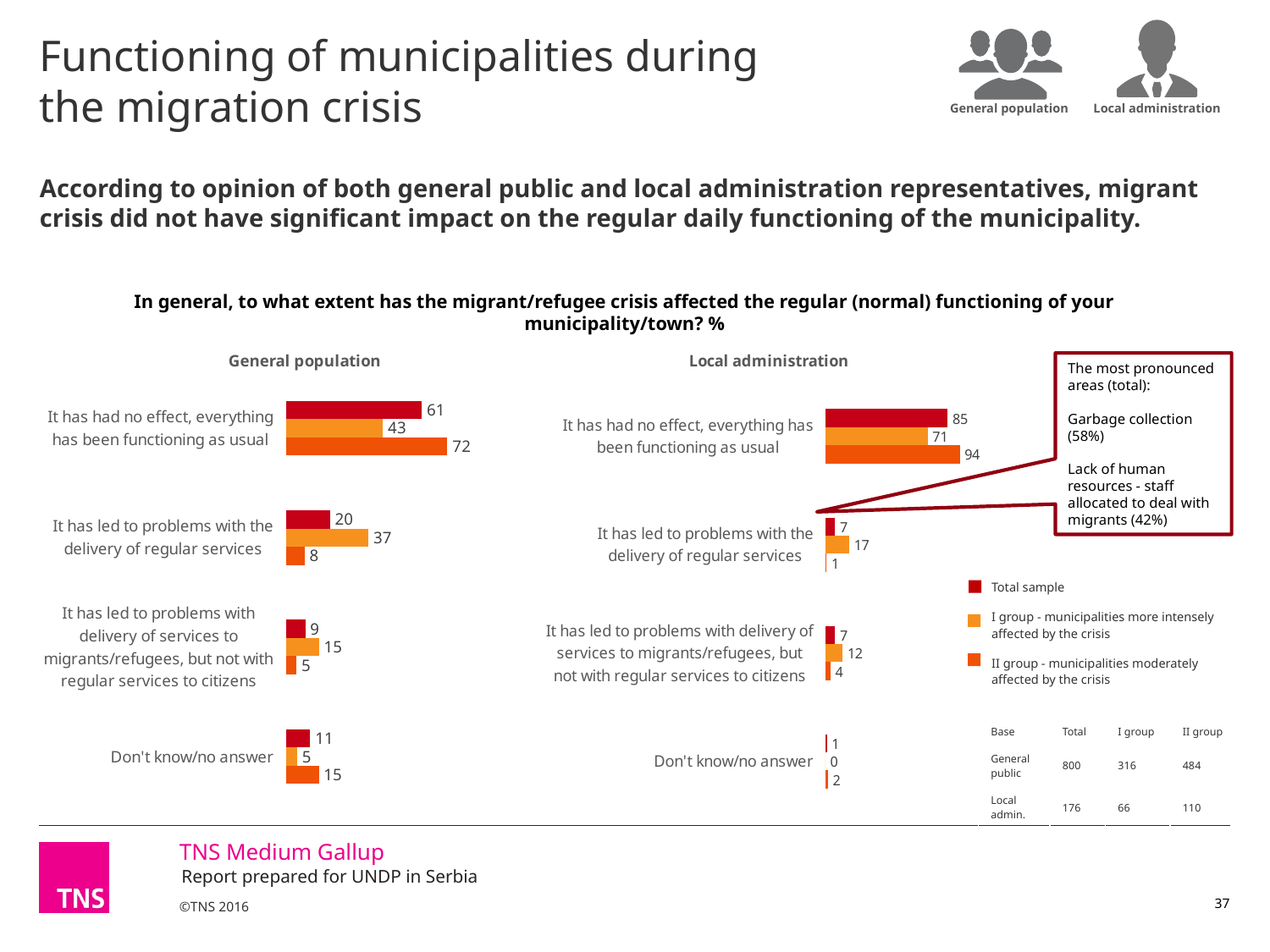
In the Local administration chart, what is the II group value for 'It has had no effect, everything has been functioning as usual'? 94 In the General population chart, what is the I group value for 'It has led to problems with the delivery of regular services'? 37 In the General population chart, which category has the highest Total sample value? It has had no effect, everything has been functioning as usual Which colour represents the Total sample series in the legend? Dark red In the General population chart, what is the Total sample value for 'It has had no effect, everything has been functioning as usual'? 61 In the General population chart, what is the difference between the II group and I group values for 'It has had no effect, everything has been functioning as usual'? 29 In the Local administration chart, what is the I group value for 'Don't know/no answer'? 0 In the Local administration chart, which category has the lowest Total sample value? Don't know/no answer How many series does the legend list? 3 In the Local administration chart, which is larger for 'It has led to problems with the delivery of regular services': the I group value or the II group value? I group How many categories are shown in the Local administration chart? 4 What type of chart is the General population chart? Bar chart